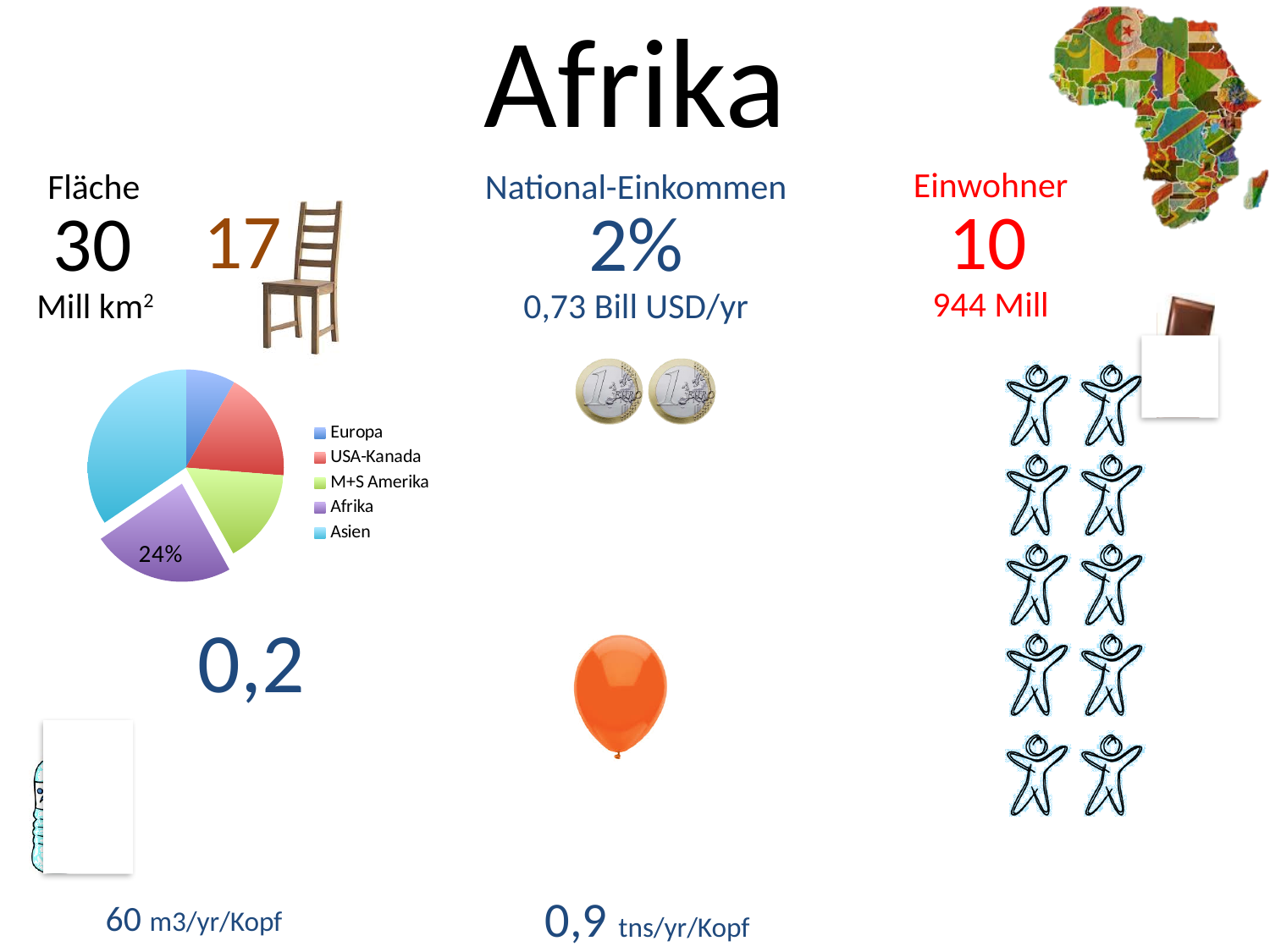
Which slice is larger, Afrika or Europa? Afrika Which category has the largest slice in the pie chart? Asien Which slice is larger, USA-Kanada or Europa? USA-Kanada How many categories does the pie chart show? 5 Which slice is larger, Asien or Afrika? Asien What kind of chart is shown on the slide? pie chart What colour is the Afrika slice in the pie chart? purple Which slice in the pie chart has a printed percentage label? Afrika How many entries does the legend of the pie chart list? 5 Which slice of the pie chart is pulled out from the rest? Afrika Which category has the smallest slice in the pie chart? Europa What share of the pie does the Afrika slice represent? 24%